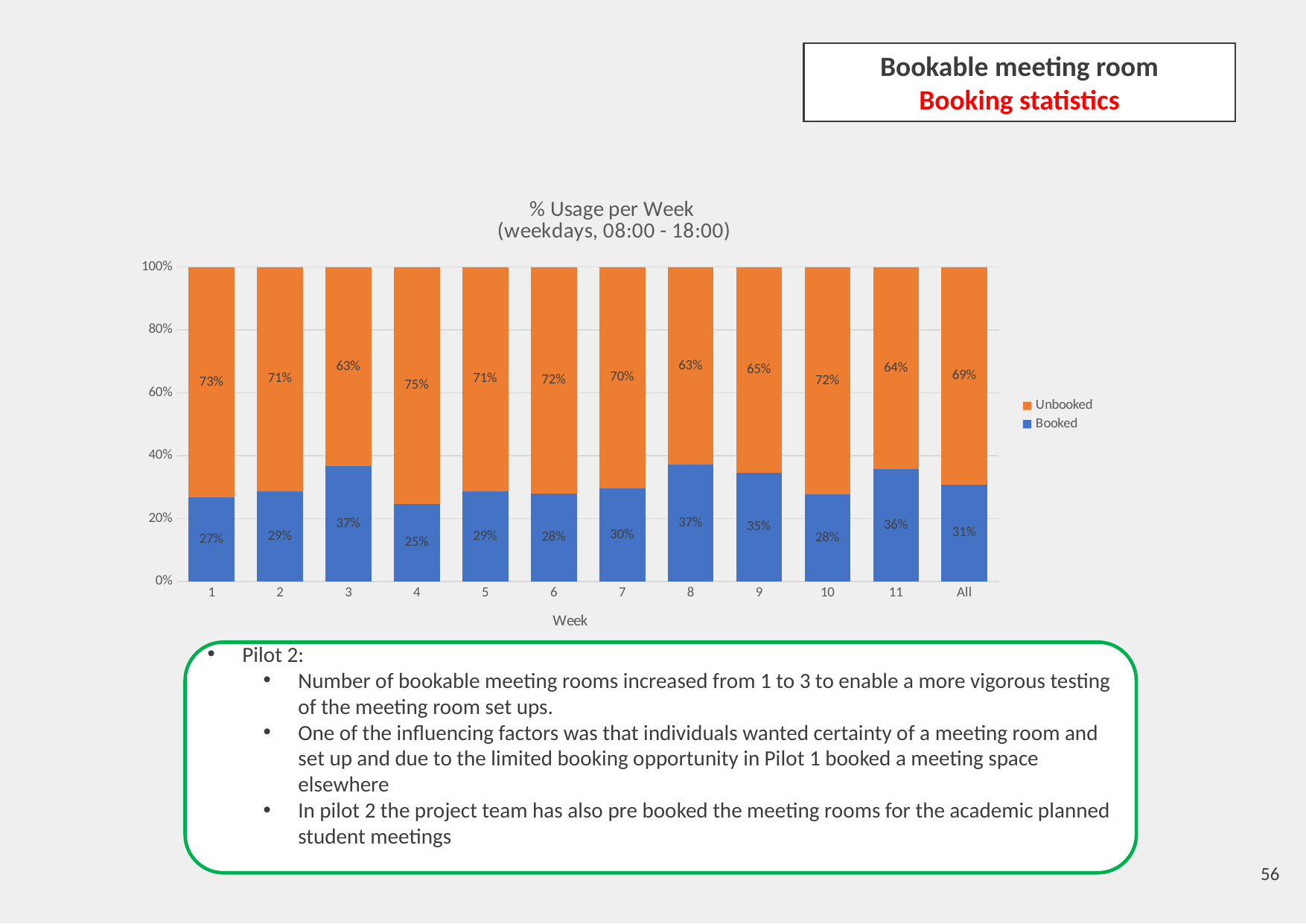
Which week has the lowest Booked percentage? 4 Which week has the highest Unbooked percentage? 4 What is the Booked percentage for week 4? 25% What is the title of the chart? % Usage per Week (weekdays, 08:00 - 18:00) What is the Unbooked percentage for week 9? 65% What kind of chart is shown on the slide? stacked bar chart How many series does the legend list? 2 What is the difference between the Booked percentage in week 8 and week 4? 12% What is the Booked percentage for the 'All' category? 31% How many categories are shown on the x axis? 12 Which is larger, the Booked percentage for week 11 or for week 10? week 11 What is the Unbooked percentage for week 7? 70%